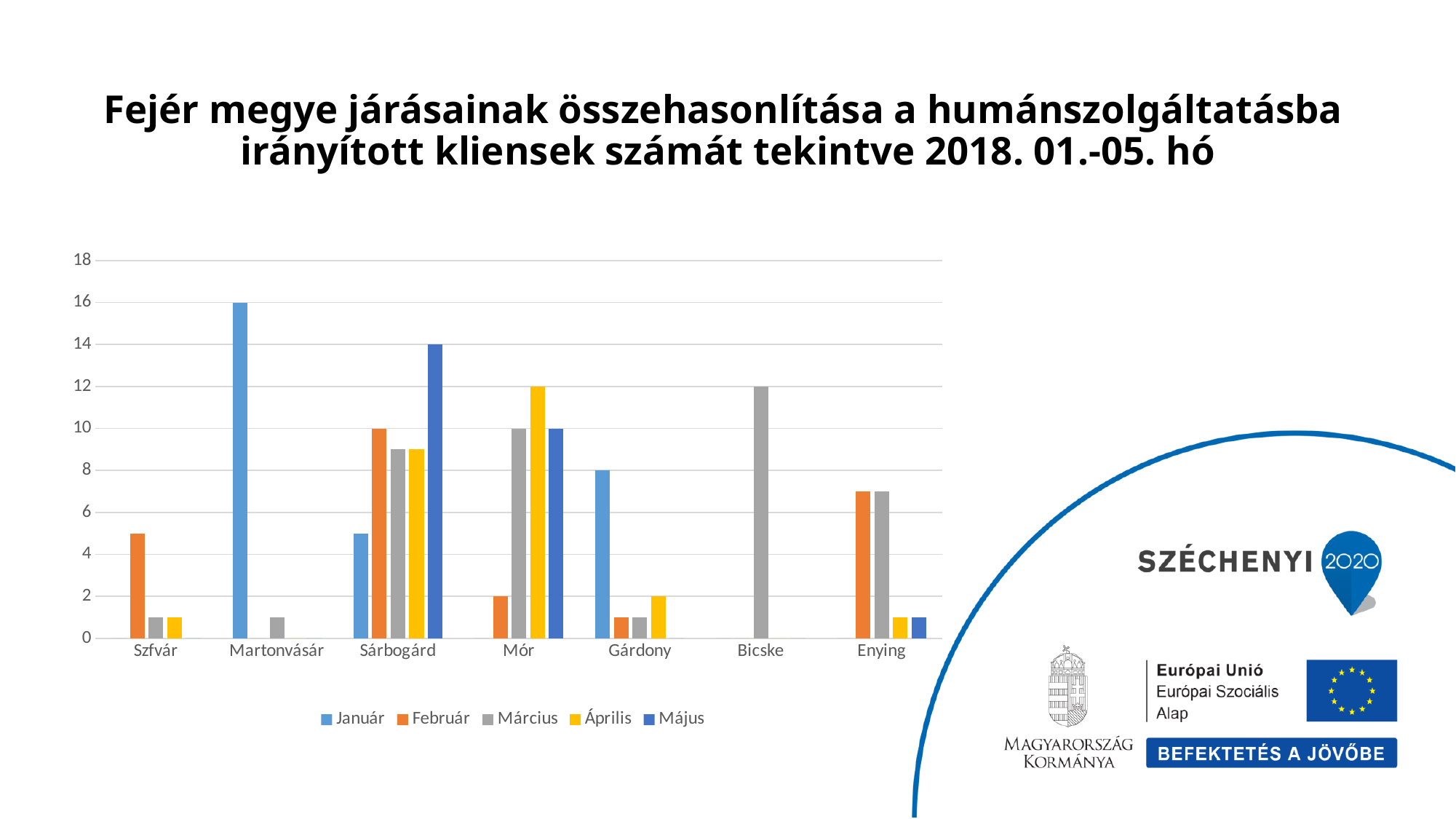
How many series does the legend list? 5 What is the value for Január in Martonvásár? 16 What is the value for Május in Sárbogárd? 14 Which district has the highest Január value? Martonvásár What is the difference between the Április value for Mór and the Április value for Gárdony? 10 What is the value for Január in Gárdony? 8 What kind of chart is shown on the slide? bar chart How many districts (categories) are shown on the x axis? 7 What is the value for Március in Bicske? 12 Which district has the highest Április value? Mór Which is larger: the Május value for Sárbogárd or the Május value for Mór? Sárbogárd Is the value for Február in Szfvár greater or less than 4? greater